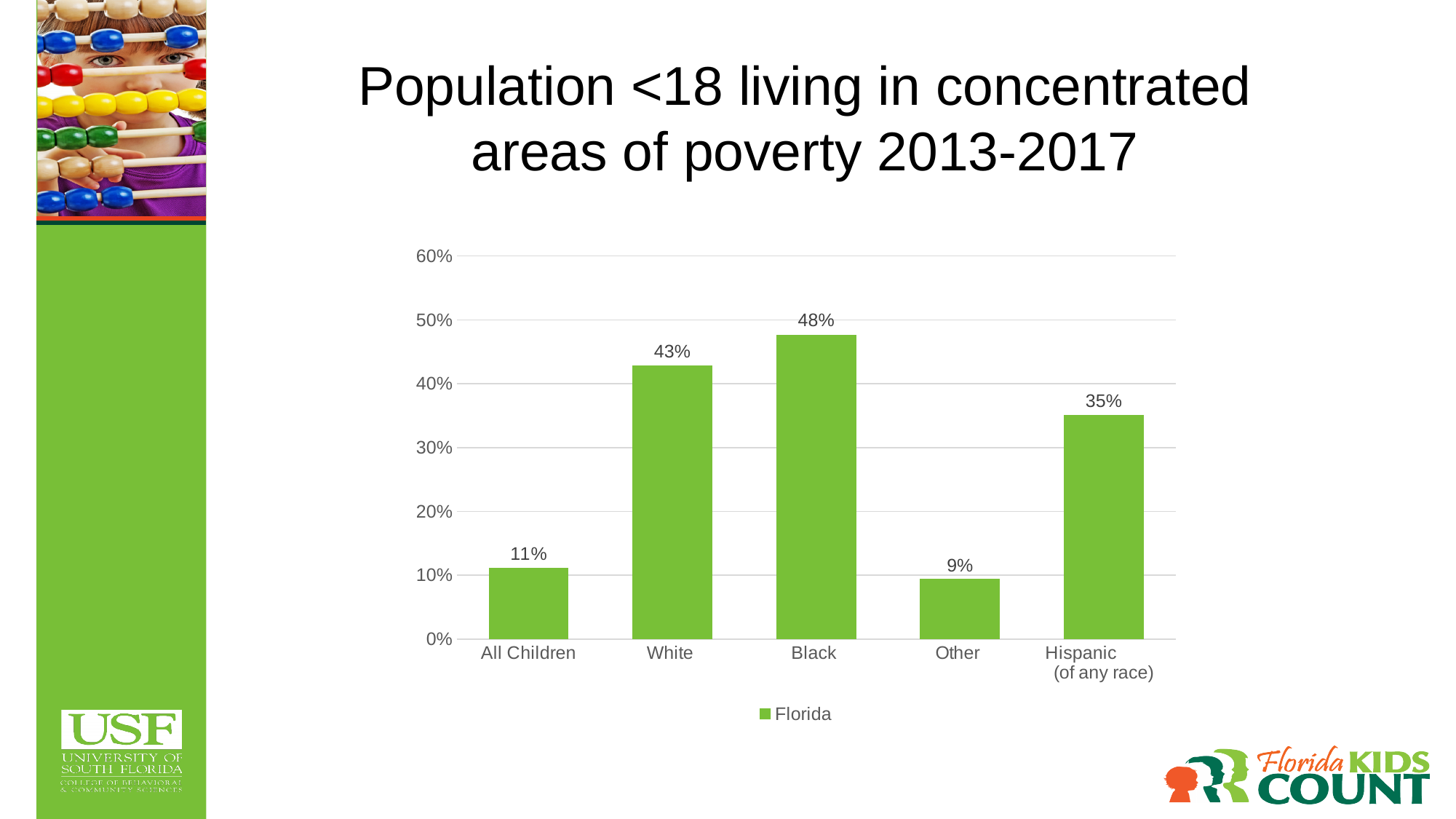
How many categories are shown on the x axis? 5 What is the value for Black? 48% How many series does the legend list? 1 What is the difference between the values for Black and White? 5% Which category has the lowest value? Other What is the value for All Children? 11% What is the difference between the values for White and Hispanic (of any race)? 8% Which is larger, the value for White or the value for Hispanic (of any race)? White What is the value for Hispanic (of any race)? 35% Which category has the highest value? Black What kind of chart is shown on the slide? bar chart Is the value for Other greater or less than 10%? less